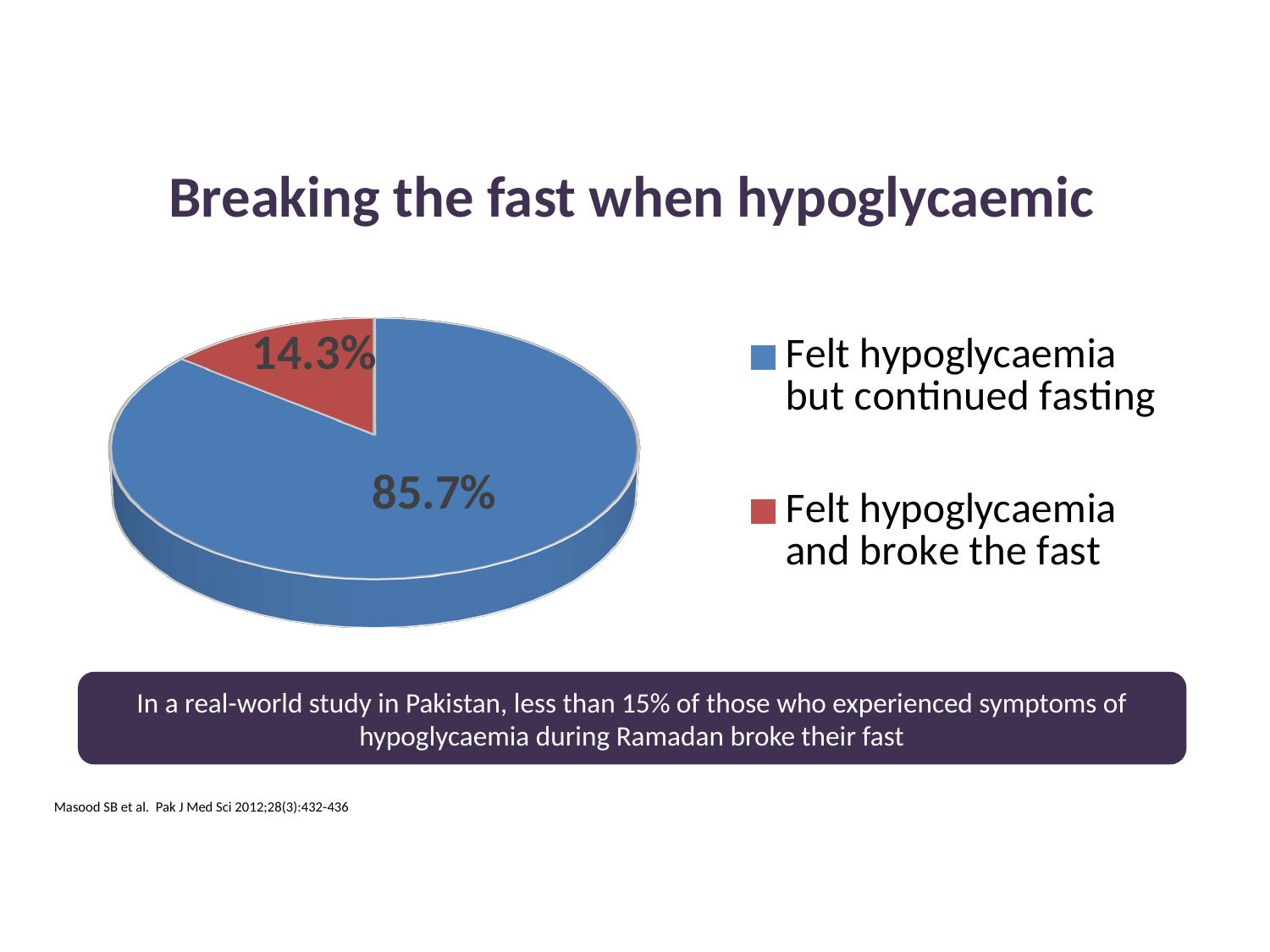
What colour is the slice for 'Felt hypoglycaemia and broke the fast'? Red What share of the pie is 'Felt hypoglycaemia but continued fasting'? 85.7% What kind of chart is shown on the slide? Pie chart Which category has the smallest slice of the pie? Felt hypoglycaemia and broke the fast Which category has the largest slice of the pie? Felt hypoglycaemia but continued fasting What is the difference in percentage points between the two slices of the pie? 71.4 Which is larger: the share for 'Felt hypoglycaemia but continued fasting' or the share for 'Felt hypoglycaemia and broke the fast'? Felt hypoglycaemia but continued fasting What is the title of the slide containing the pie chart? Breaking the fast when hypoglycaemic What share of the pie is 'Felt hypoglycaemia and broke the fast'? 14.3% How many entries does the legend list? 2 How many slices does the pie chart have? 2